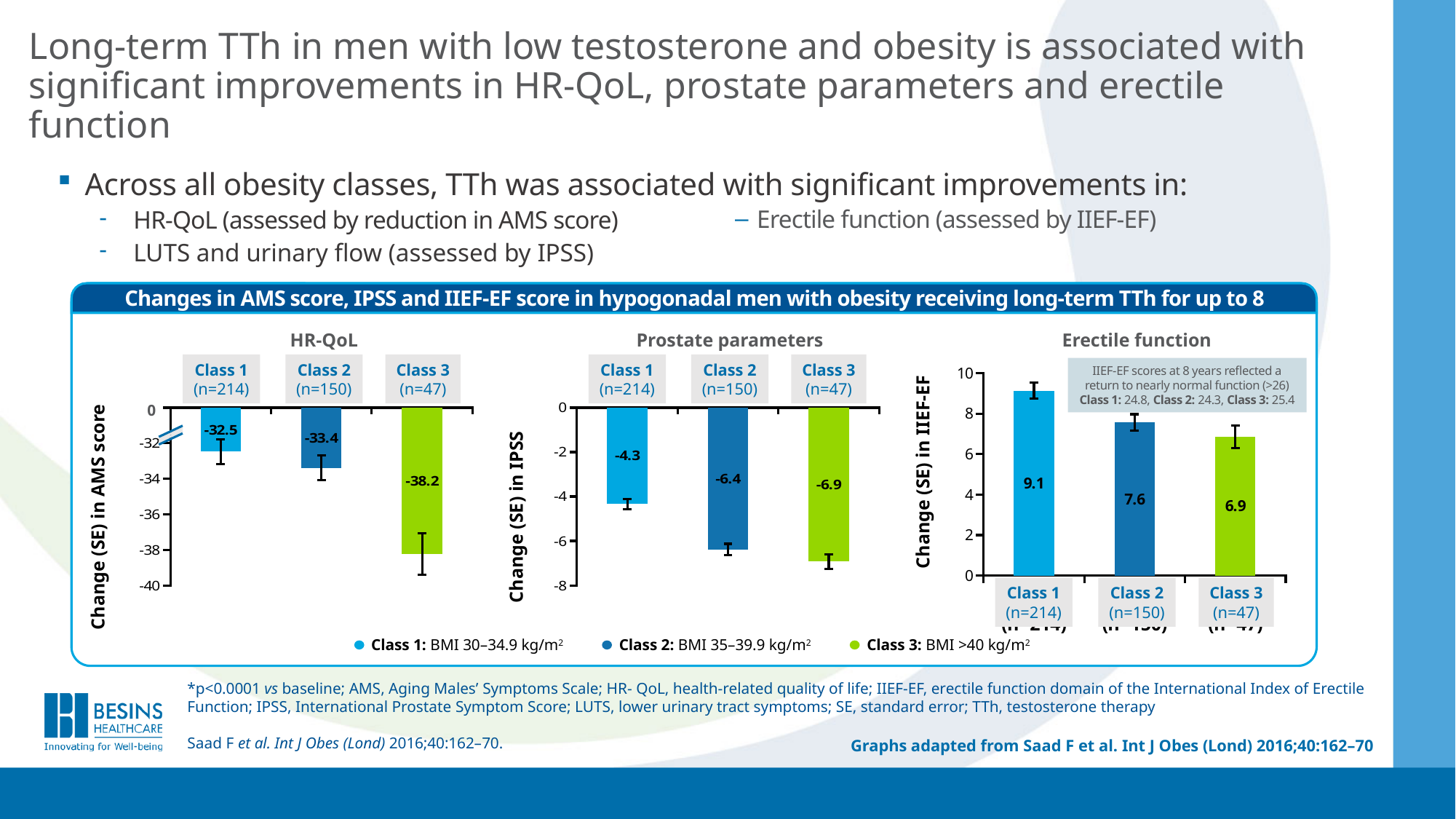
In the HR-QoL chart, what is the change in AMS score for Class 3 (n=47)? -38.2 In the Prostate parameters chart, what is the change in IPSS for Class 2 (n=150)? -6.4 In the Erectile function chart, which class has the lowest change in IIEF-EF? Class 3 In the Erectile function chart, what is the difference between the Class 1 and Class 2 values? 1.5 According to the legend, what BMI range defines Class 2? BMI 35–39.9 kg/m2 In the Prostate parameters chart, is the reduction in IPSS larger for Class 1 or Class 2? Class 2 How many classes are plotted in the Erectile function chart? 3 In the HR-QoL chart, what is the change in AMS score for Class 1 (n=214)? -32.5 In the HR-QoL chart, which class shows the largest reduction in AMS score? Class 3 In the Erectile function chart, what is the change in IIEF-EF for Class 1 (n=214)? 9.1 What kind of chart is the Prostate parameters chart? Bar chart In the Prostate parameters chart, what is the difference between the Class 1 and Class 3 changes in IPSS? 2.6